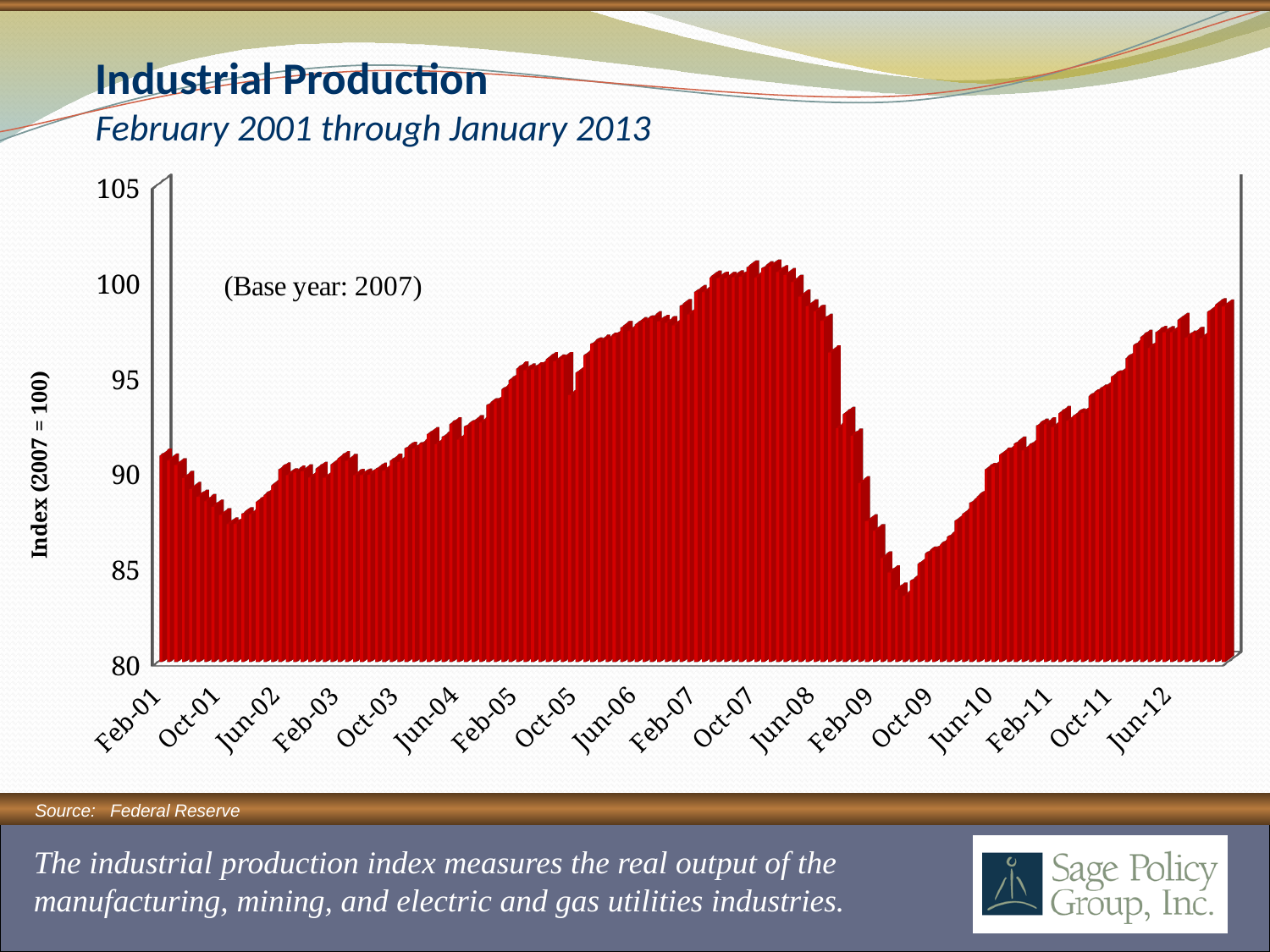
What is the title of the chart on the slide? Industrial Production Which is larger, the value for Oct-07 or the value for Feb-09? Oct-07 Do the values rise or fall between Oct-07 and Feb-09? fall Is the value for Oct-07 greater or less than 100? greater Is the value for Jun-04 greater or less than 90? greater Is the lowest value on the chart greater or less than 85? less Do the values rise or fall between Oct-09 and Jun-12? rise What is the label on the vertical axis of the chart? Index (2007 = 100) What kind of chart is shown on the slide? bar chart